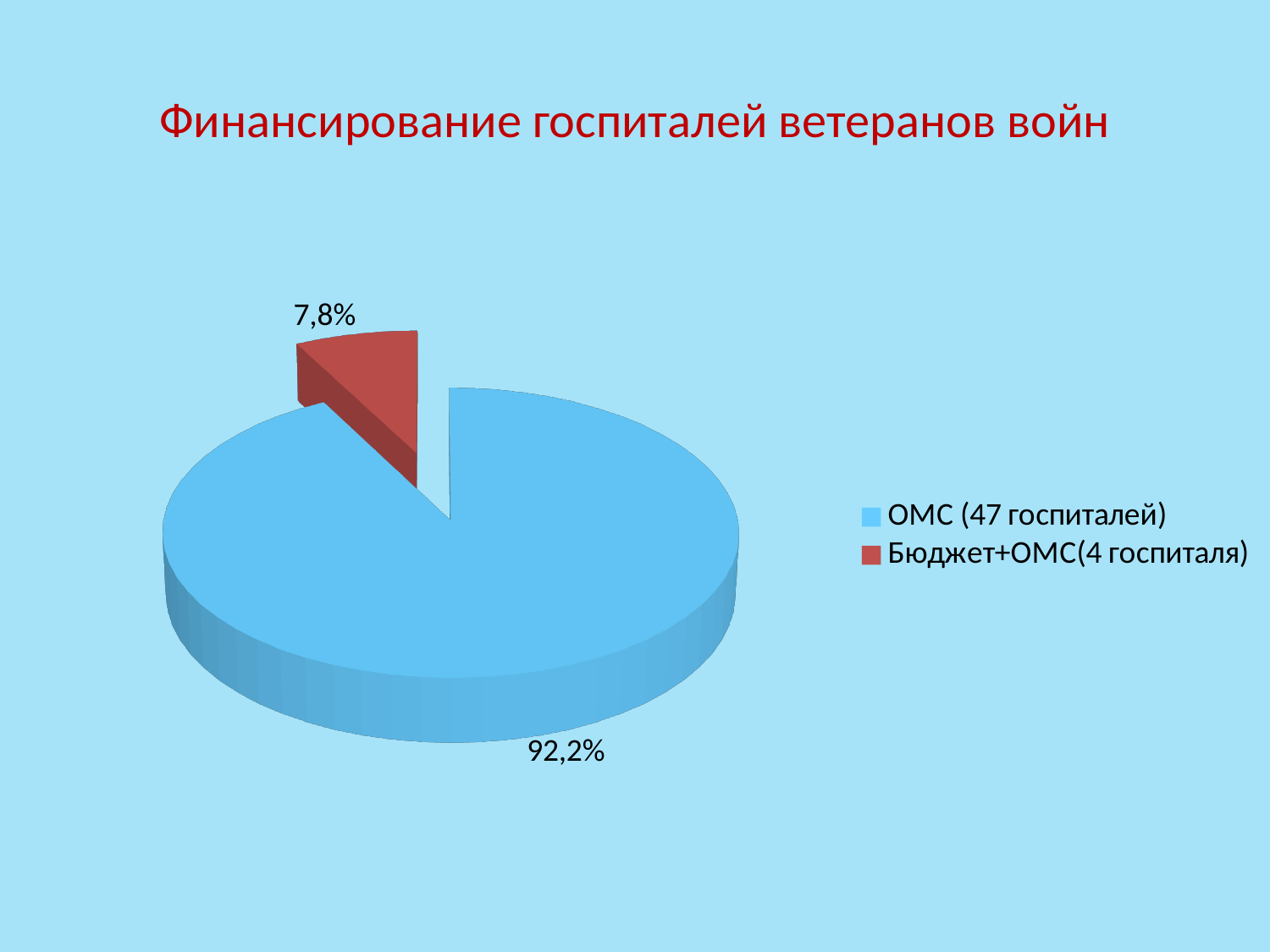
What colour is the slice for Бюджет+ОМС(4 госпиталя)? red What type of chart is shown on the slide? pie chart Which category has the smallest slice of the pie? Бюджет+ОМС(4 госпиталя) What share of the pie does Бюджет+ОМС(4 госпиталя) represent? 7,8% What is the title of the chart? Финансирование госпиталей ветеранов войн Which is larger: the share for ОМС (47 госпиталей) or the share for Бюджет+ОМС(4 госпиталя)? ОМС (47 госпиталей) What is the difference in percentage points between the ОМС (47 госпиталей) slice and the Бюджет+ОМС(4 госпиталя) slice? 84,4 What share of the pie does ОМС (47 госпиталей) represent? 92,2% Which category has the largest slice of the pie? ОМС (47 госпиталей) How many entries does the legend list? 2 How many slices does the pie chart have? 2